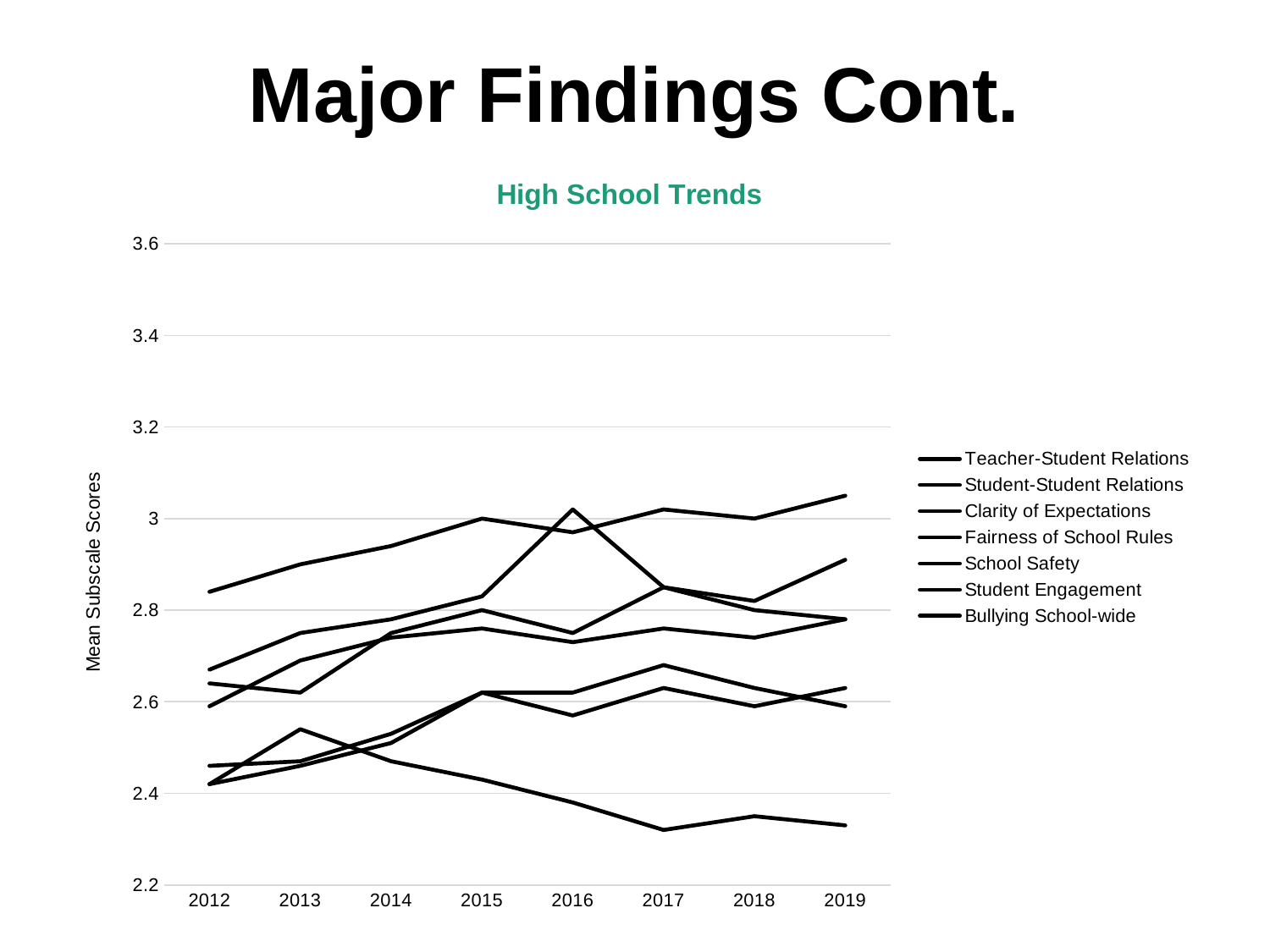
Is the lowest value plotted for 2012 greater or less than 2.6? less Is the lowest value plotted for 2019 greater or less than 2.4? less What kind of chart is shown on the slide? line chart What is the label on the y axis? Mean Subscale Scores How many years are shown along the x axis? 8 What is the title of the chart? High School Trends How many series does the legend list? 7 Is the highest value plotted for 2012 greater or less than 3? less